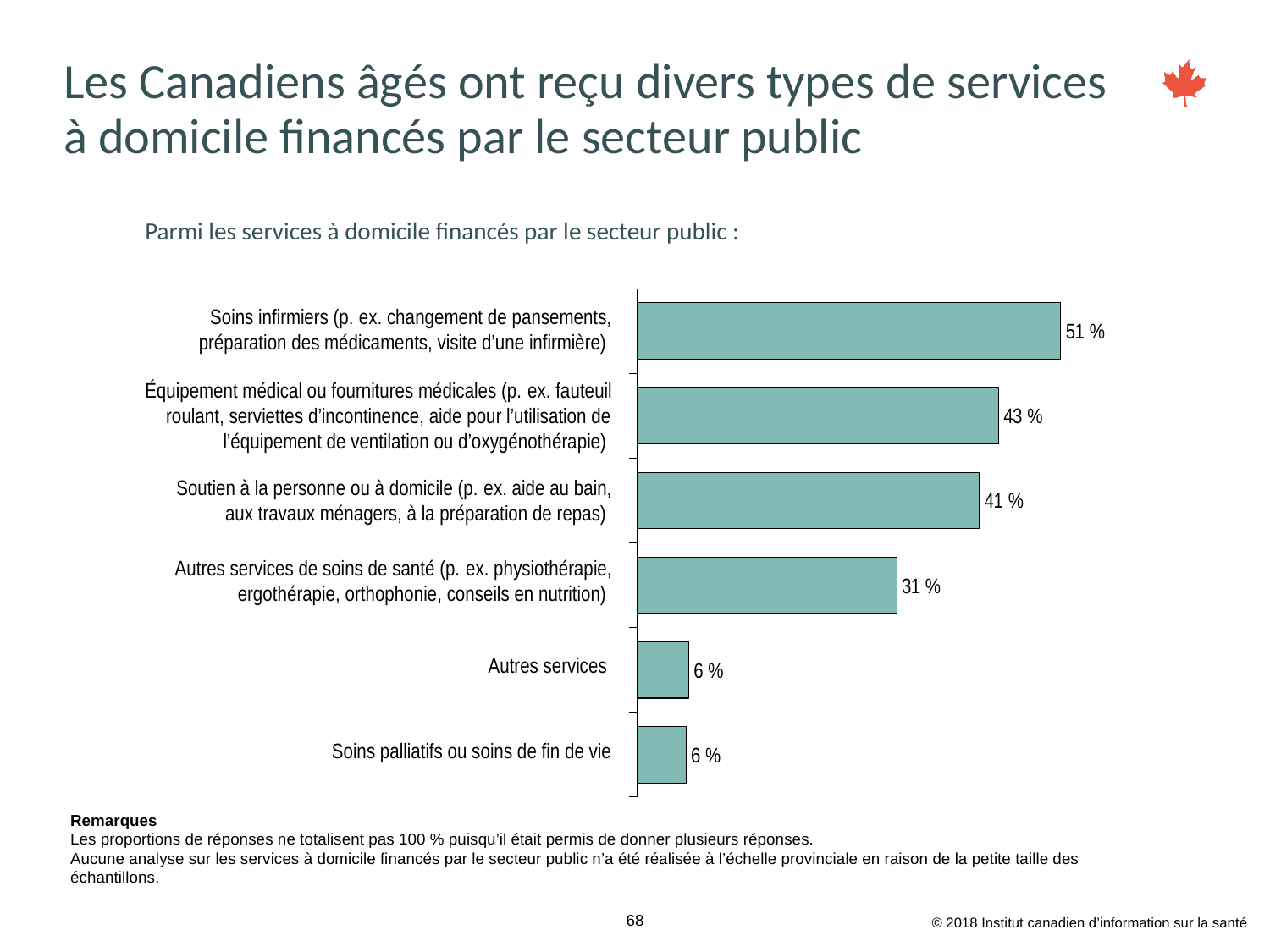
What is the subtitle text shown above the chart? Parmi les services à domicile financés par le secteur public : Which is larger, the value for Soutien à la personne ou à domicile or the value for Autres services de soins de santé? Soutien à la personne ou à domicile What is the value for Autres services de soins de santé? 31 % What kind of chart is shown on the slide? Bar chart What is the value for Soutien à la personne ou à domicile? 41 % What is the value for Équipement médical ou fournitures médicales? 43 % Which category has the highest value? Soins infirmiers What is the difference between the values for Équipement médical ou fournitures médicales and Soutien à la personne ou à domicile? 2 % What is the value for Soins infirmiers? 51 % What is the difference between the values for Soins infirmiers and Autres services de soins de santé? 20 % How many categories are shown in the chart? 6 What is the value for Soins palliatifs ou soins de fin de vie? 6 %